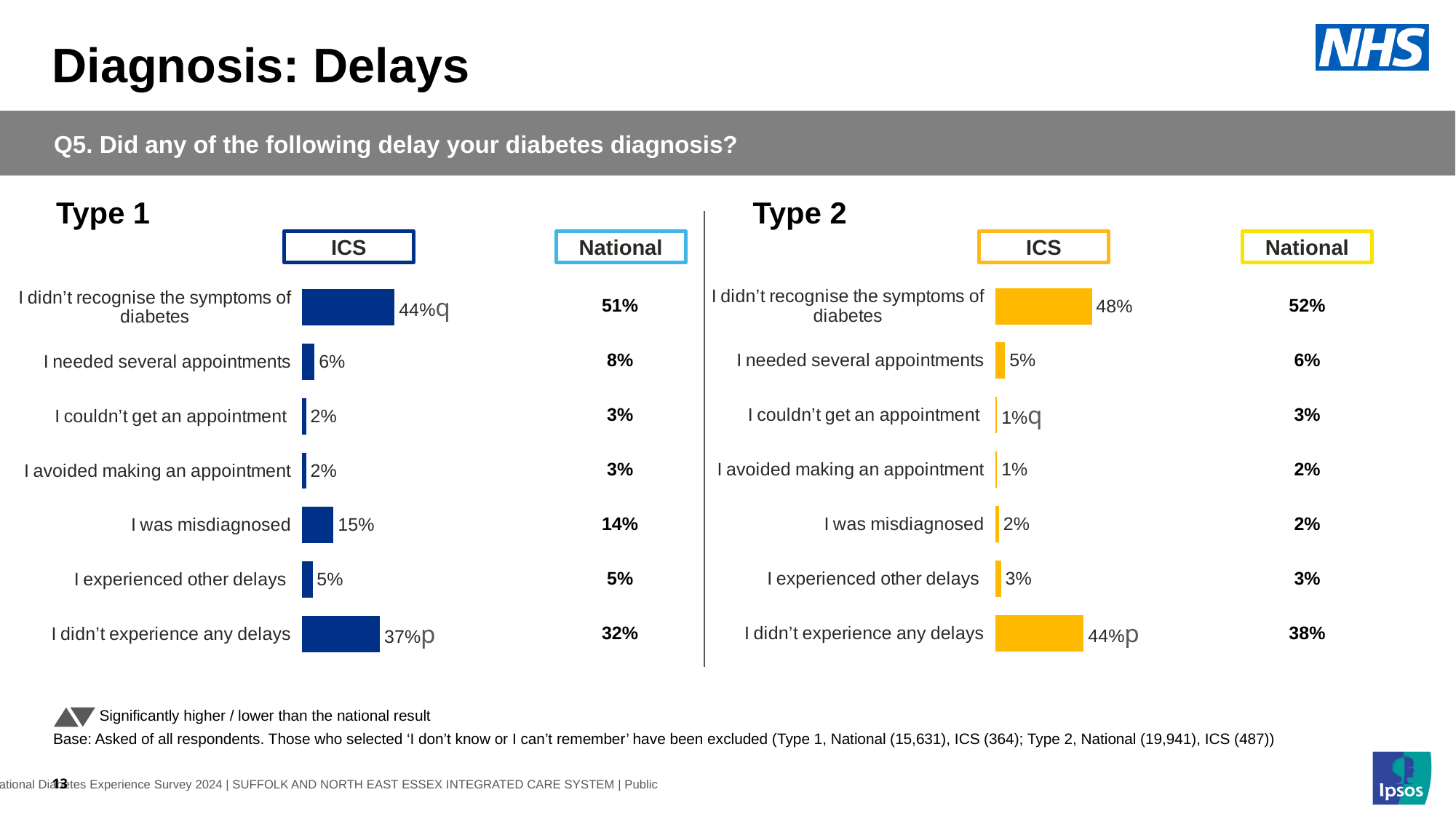
In the Type 2 chart, what is the difference between the ICS and National values for 'I didn't experience any delays'? 6% In the Type 2 chart, what is the ICS value for 'I couldn't get an appointment'? 1% In the Type 1 chart, what is the ICS value for 'I didn't recognise the symptoms of diabetes'? 44% How many categories are shown in the Type 1 chart? 7 In the Type 2 chart, which category has the highest ICS value? I didn't recognise the symptoms of diabetes In the Type 1 chart, is the ICS value for 'I was misdiagnosed' larger or smaller than the National value? larger In the Type 2 chart, what is the ICS value for 'I didn't experience any delays'? 44% In the Type 2 chart, what is the National value for 'I needed several appointments'? 6% What kind of chart is used for the ICS values in the Type 2 chart? bar chart In the Type 1 chart, which category has the highest ICS value? I didn't recognise the symptoms of diabetes In the Type 1 chart, what is the difference between the National and ICS values for 'I didn't recognise the symptoms of diabetes'? 7% In the Type 1 chart, what is the National value for 'I was misdiagnosed'? 14%